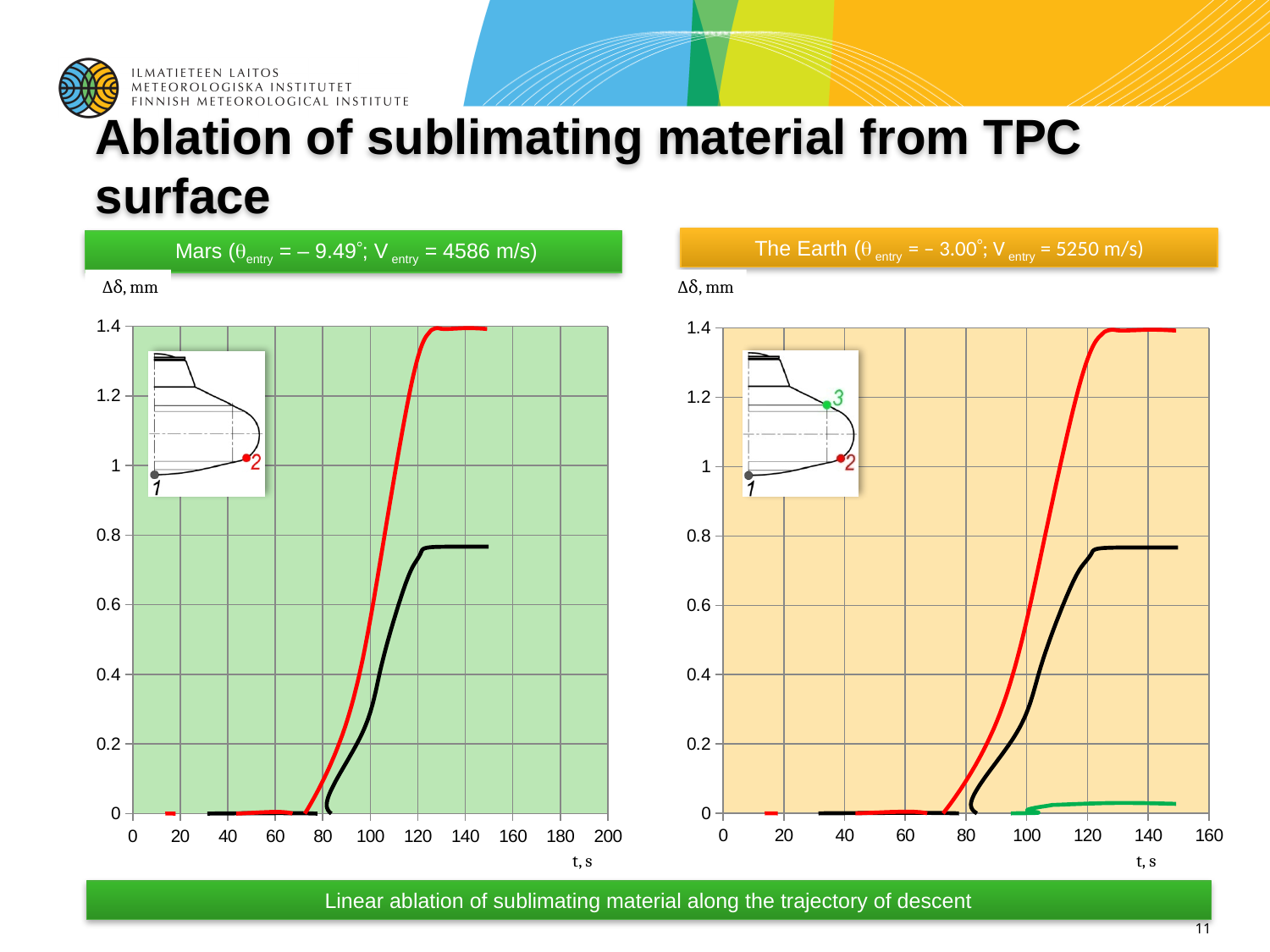
How many lines are plotted on the Mars chart on the left? 2 How many lines are plotted on The Earth chart on the right? 3 On the Mars chart, is the value of the red line at t = 140 s greater or less than 1.2? greater On the Mars chart, is the value of the black line at t = 80 s greater or less than 0.2? less On The Earth chart, which line is higher at t = 120 s, the red line or the green line? red line On the Mars chart, is the value of the black line at t = 140 s greater or less than 0.6? greater What kind of chart is the Mars chart on the left? line chart On the Mars chart, which line is higher at t = 140 s, the red line or the black line? red line On the Mars chart, do the plotted values rise or fall as t increases from 80 s to 120 s? rise What is the label of the x axis on The Earth chart? t, s